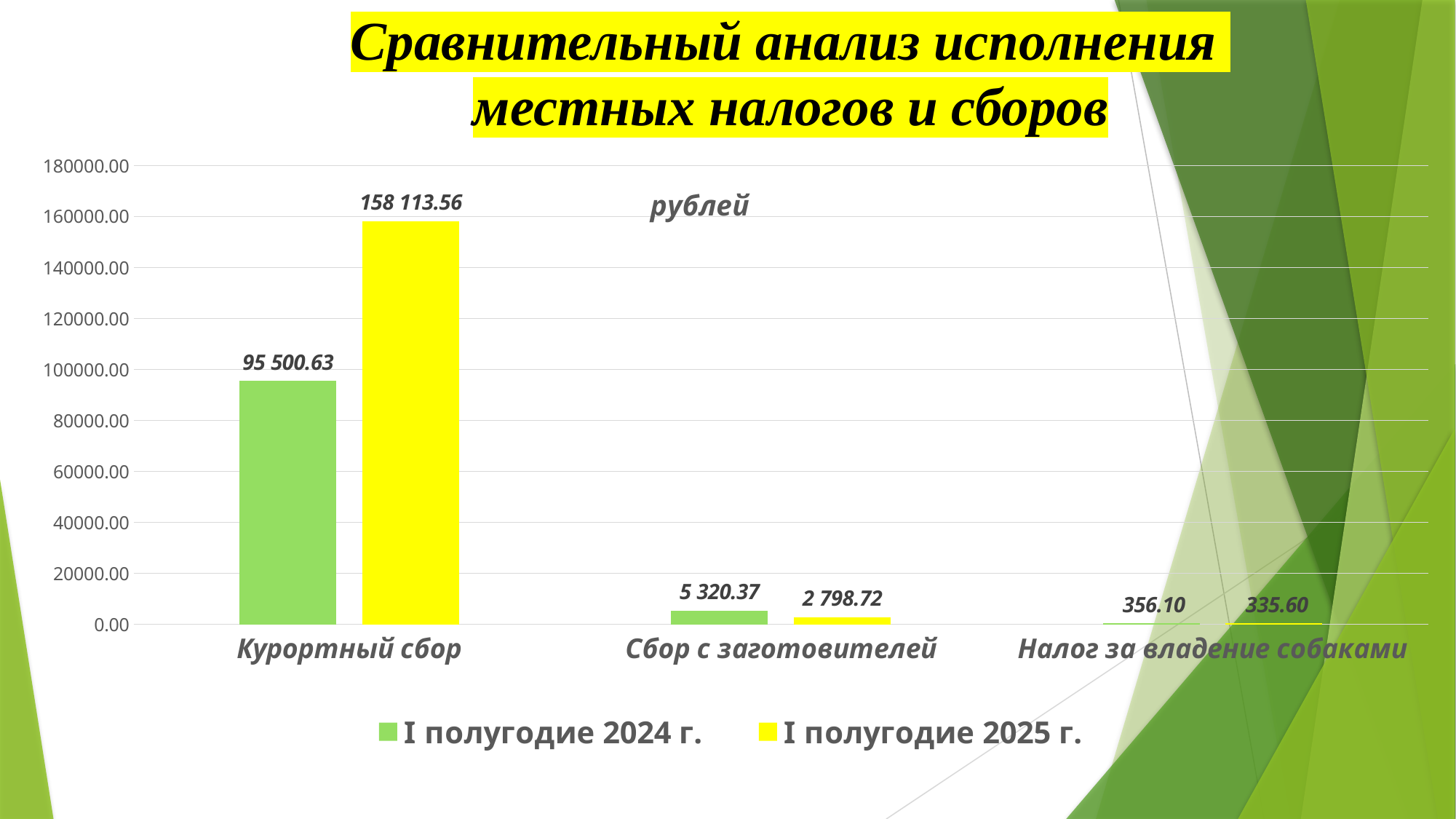
What kind of chart is shown on the slide? bar chart Which category has the highest value in I полугодие 2024 г.? Курортный сбор How many categories are shown on the x axis? 3 Is the value for Курортный сбор in I полугодие 2024 г. greater or less than 100000.00? less What is the value for Курортный сбор in I полугодие 2025 г.? 158 113.56 What is the value for Налог за владение собаками in I полугодие 2025 г.? 335.60 For Сбор с заготовителей, which is larger: the I полугодие 2024 г. value or the I полугодие 2025 г. value? I полугодие 2024 г. What is the difference between the I полугодие 2025 г. and I полугодие 2024 г. values for Курортный сбор? 62 612.93 What is the value for Сбор с заготовителей in I полугодие 2024 г.? 5 320.37 Which category has the lowest value in I полугодие 2025 г.? Налог за владение собаками What is the difference between the I полугодие 2024 г. and I полугодие 2025 г. values for Сбор с заготовителей? 2 521.65 How many series does the legend list? 2